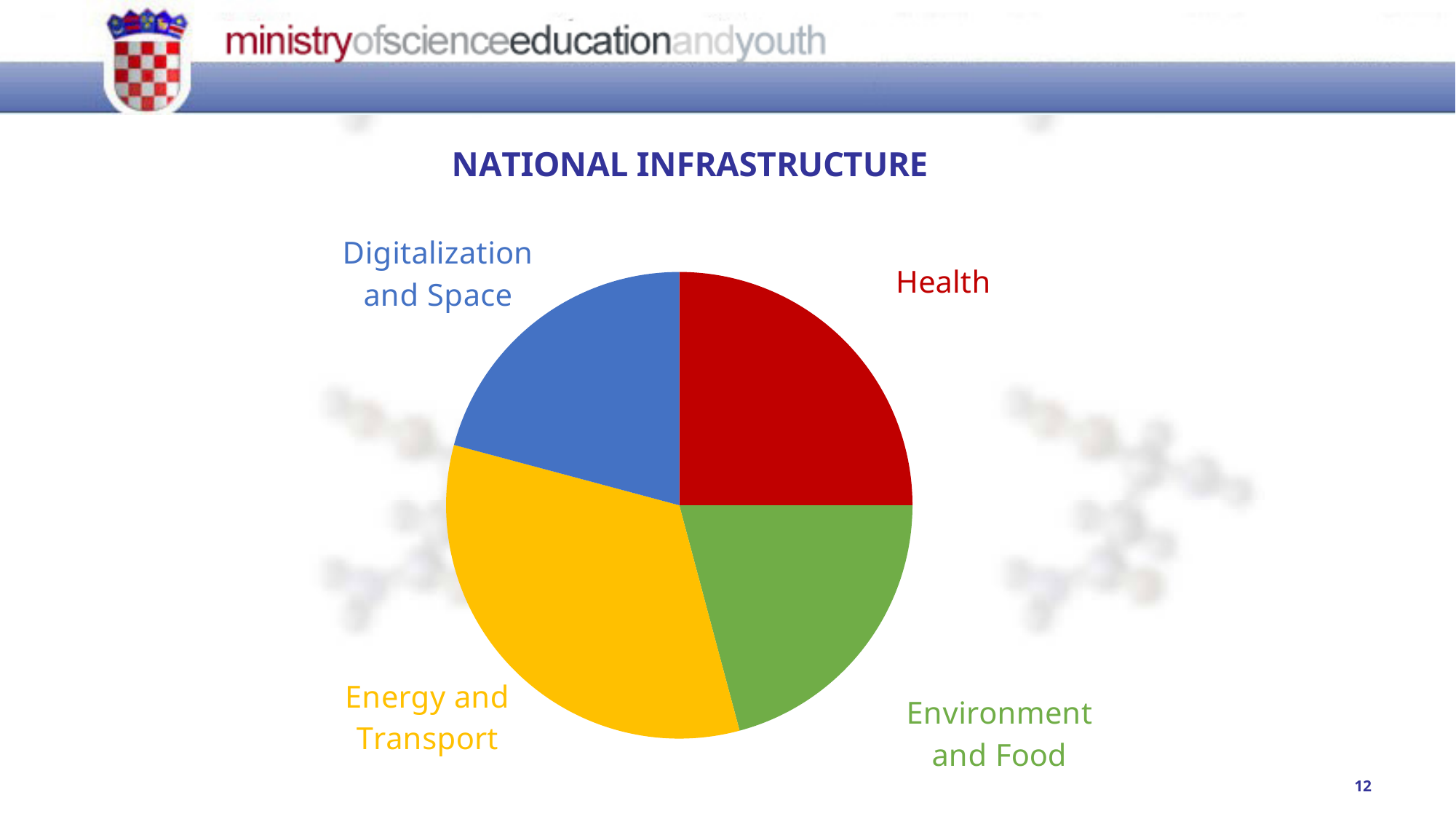
Which category has the largest slice of the pie chart? Energy and Transport Which slice is larger, Energy and Transport or Environment and Food? Energy and Transport What kind of chart is shown on the slide? pie chart What is the title of the chart? NATIONAL INFRASTRUCTURE Which slice is larger, Health or Digitalization and Space? Health Which slice is larger, Energy and Transport or Health? Energy and Transport What colour is the Health slice of the pie chart? red How many slices does the pie chart have? 4